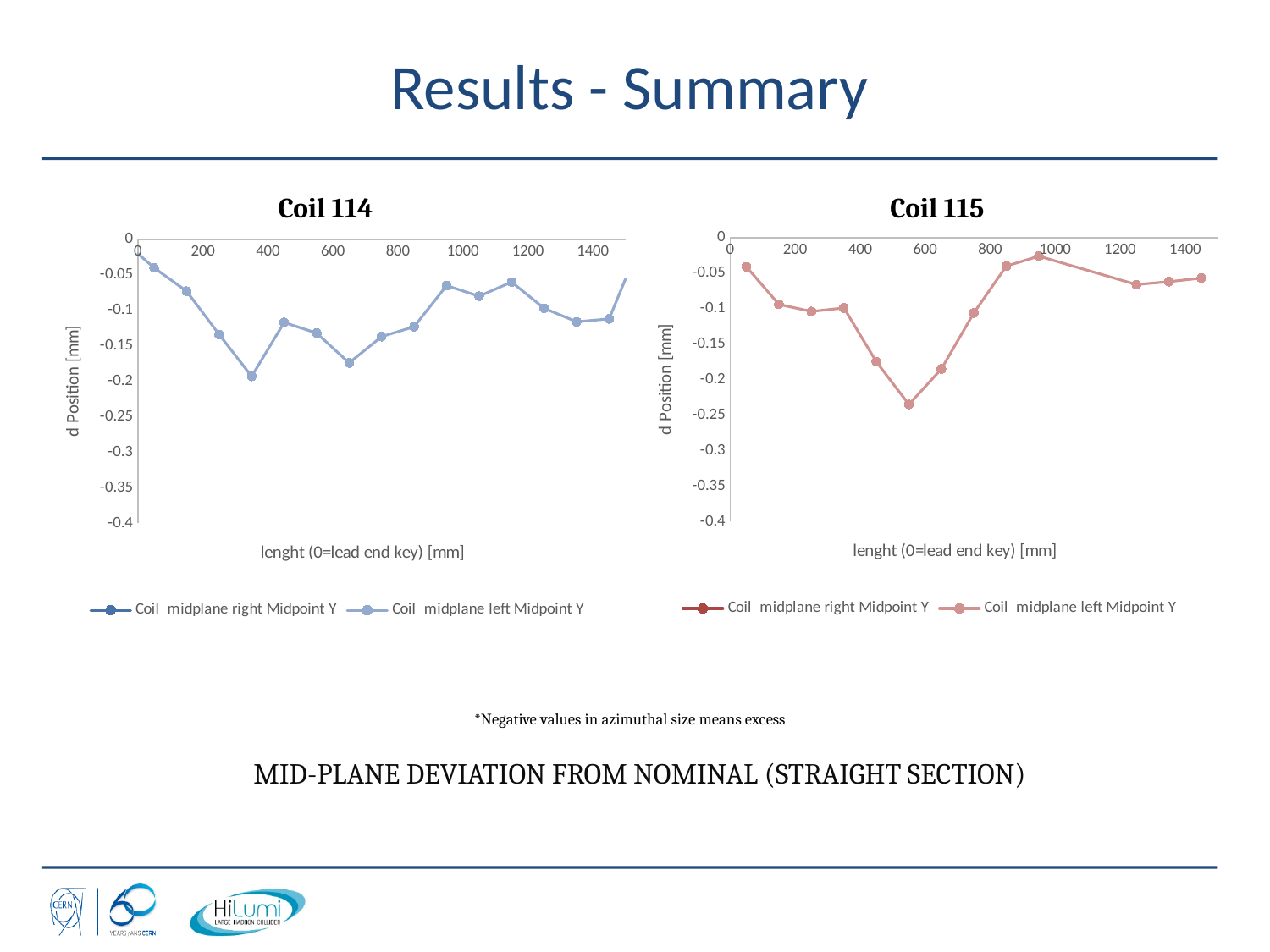
How many series does the legend of the Coil 115 chart list? 2 In the Coil 115 chart, is the value at length 150 mm larger or smaller than the value at length 450 mm? larger In the Coil 114 chart, is the value at length 950 mm greater or less than -0.1? greater In the Coil 115 chart, do the values rise or fall between length 550 mm and length 950 mm? rise In the Coil 114 chart, is the value at length 350 mm greater or less than -0.25? greater In the Coil 115 chart, is the value at length 950 mm greater or less than -0.05? greater Which chart reaches a lower minimum value, Coil 114 or Coil 115? Coil 115 What is the y-axis title of the Coil 114 chart? d Position [mm] What kind of chart is the Coil 114 chart? line chart